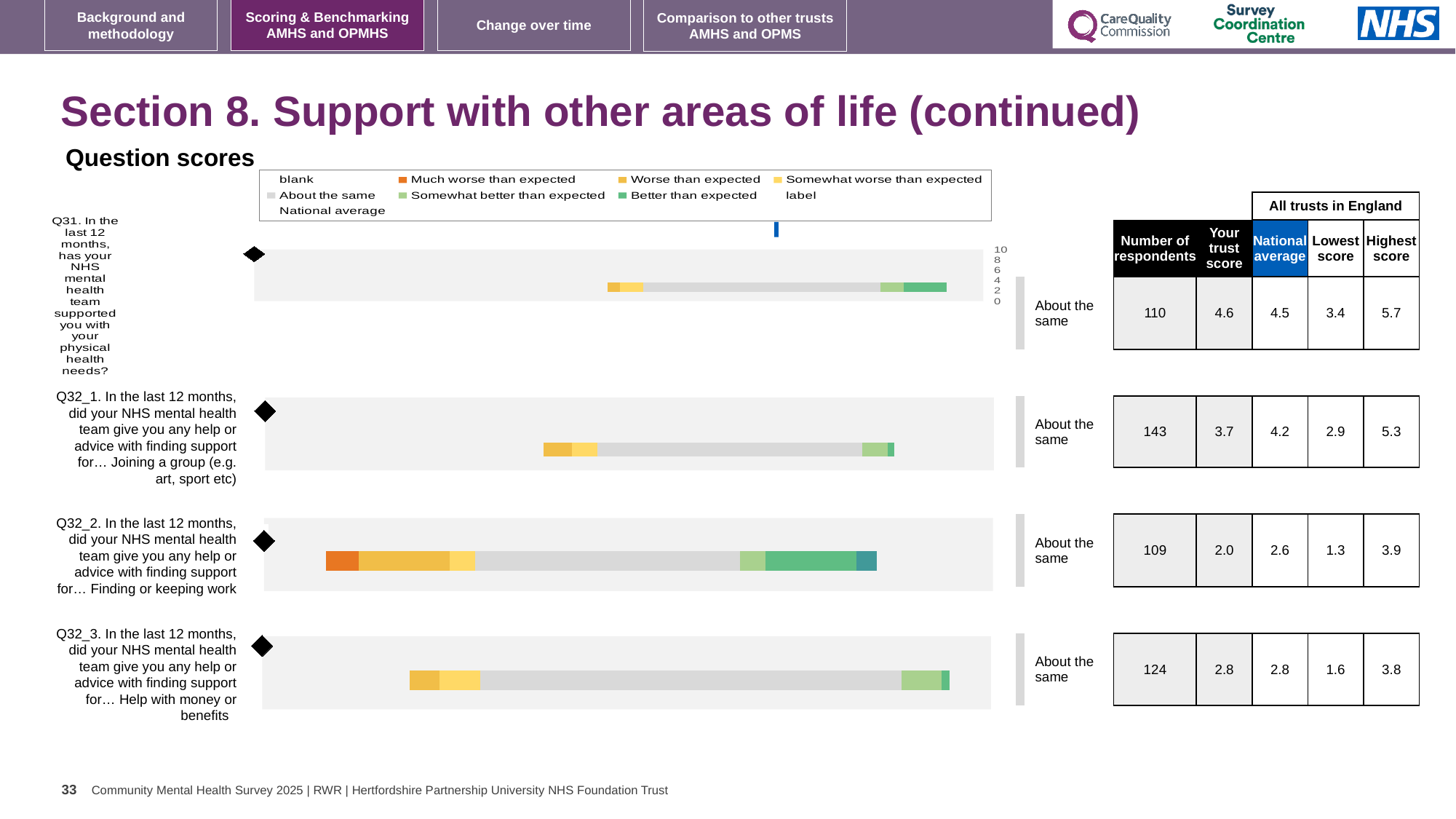
What is the national average for Q32_2 (help with finding or keeping work)? 2.6 What is the difference between the national average and the trust score for Q32_1 (help with joining a group)? 0.5 What kind of chart is used to show the question scores on this slide? Bar chart Which question has the lowest 'Your trust score'? Q32_2 (finding or keeping work) Which question has the highest number of respondents? Q32_1 (joining a group) How many respondents are shown for Q32_1 (help with joining a group)? 143 How many questions (bars) are plotted in the question scores chart? 4 What colour represents 'Much worse than expected' in the legend? Orange For Q31, which is larger: the trust score or the national average? Trust score What is the highest score among all trusts in England for Q32_3 (help with money or benefits)? 3.8 What is the 'Your trust score' value for Q31 (support with physical health needs)? 4.6 How many entries does the legend of the question scores chart list? 9